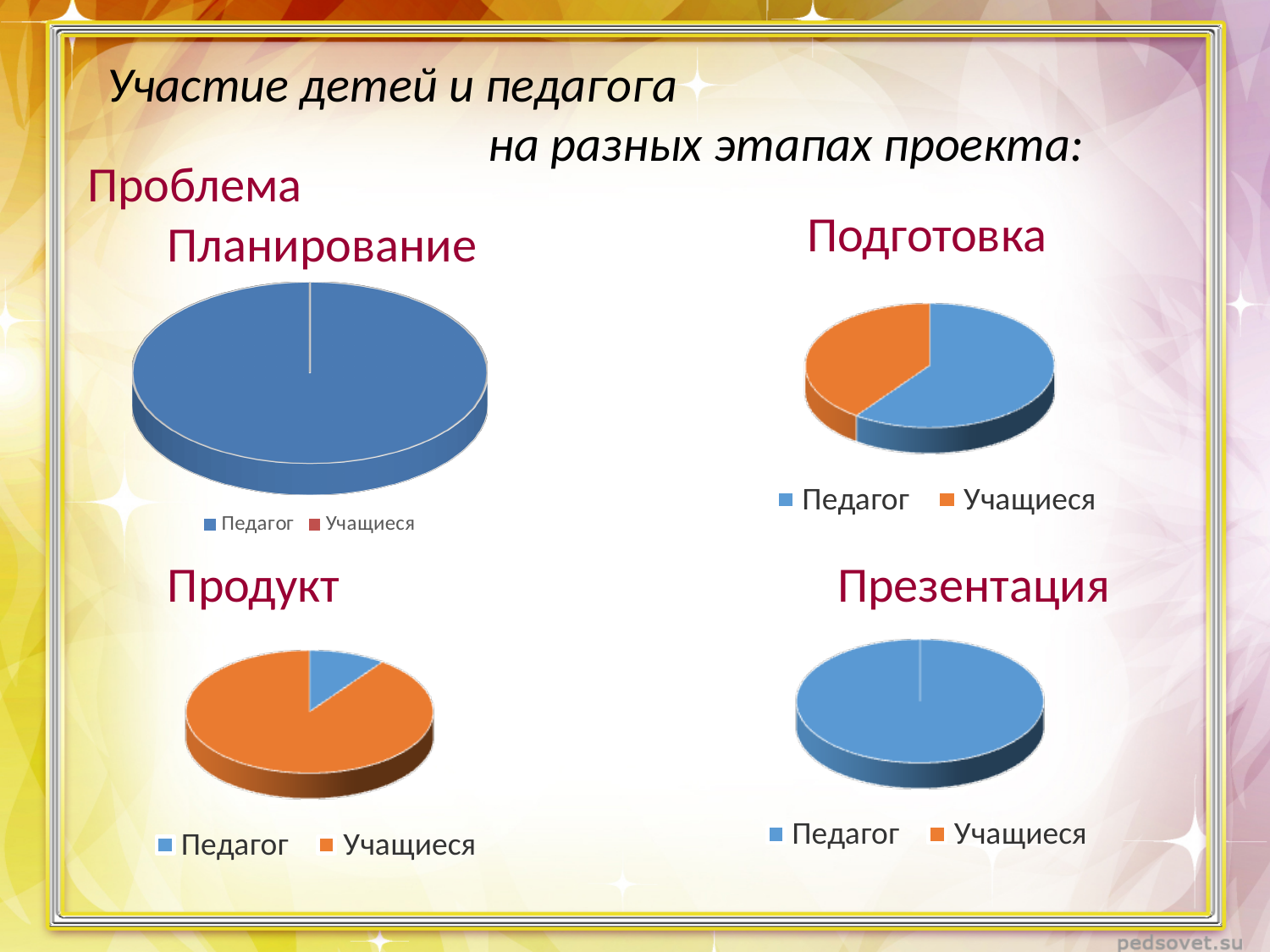
In the "Подготовка" chart, which category has the largest slice? Педагог In the "Продукт" chart, which slice is larger, Педагог or Учащиеся? Учащиеся How many pie charts are shown on the slide? 4 In the "Подготовка" chart, what colour represents Учащиеся? orange In the "Подготовка" chart, which slice is larger, Педагог or Учащиеся? Педагог In the "Презентация" chart, which category fills the entire pie? Педагог In the "Продукт" chart, which category has the smallest slice? Педагог In the "Планирование" chart, which category fills the entire pie? Педагог What kind of chart is used under the heading "Планирование"? pie chart How many series does the legend of the "Подготовка" chart list? 2 What are the two legend entries of the "Продукт" chart? Педагог, Учащиеся